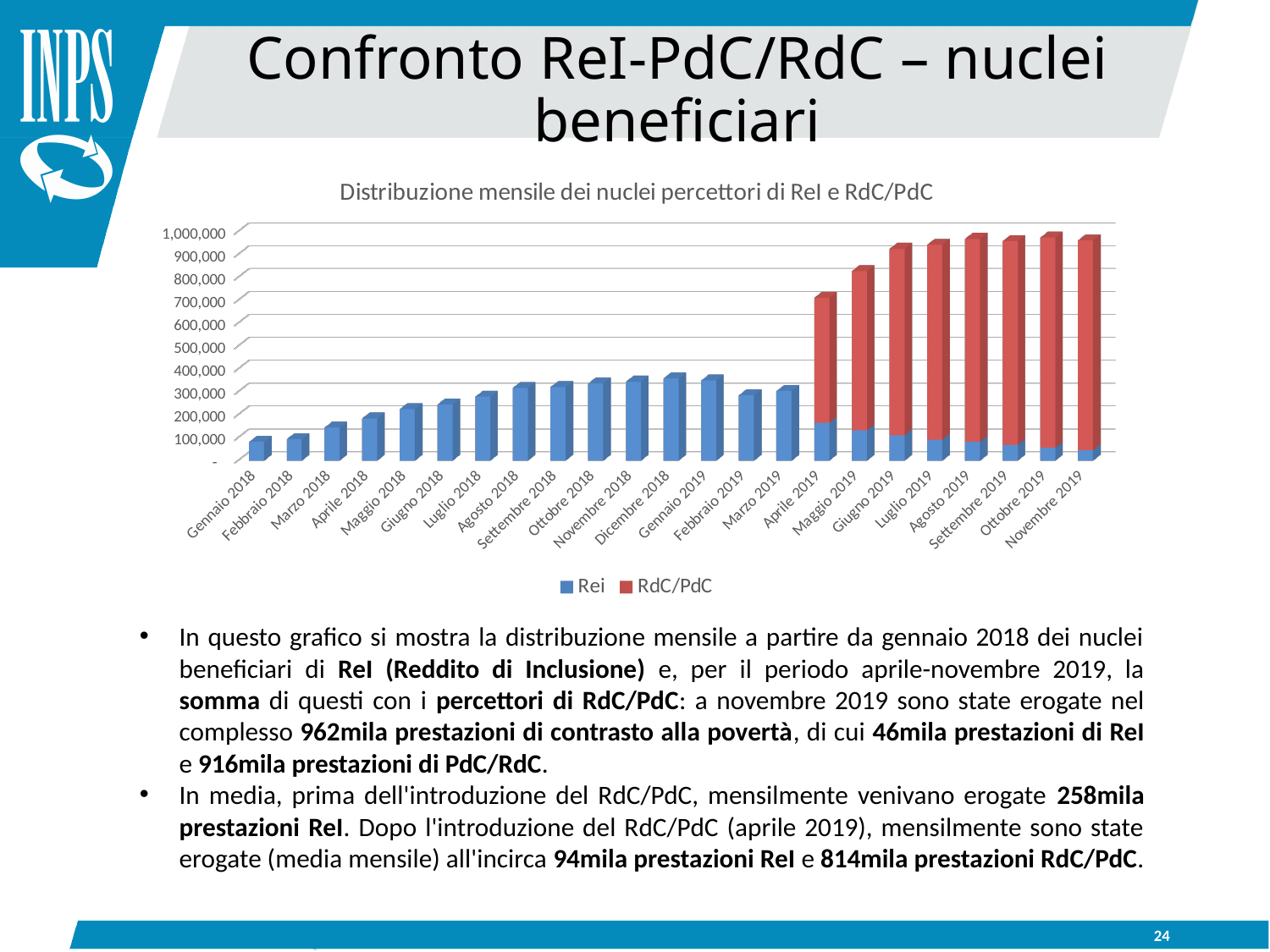
What is the title of the chart? Distribuzione mensile dei nuclei percettori di ReI e RdC/PdC Is the total bar for Luglio 2019 greater or less than 900,000? greater Which is larger, the Rei value for Dicembre 2018 or for Gennaio 2018? Dicembre 2018 Do the Rei values rise or fall from Aprile 2019 to Novembre 2019? Fall Is the Rei value for Dicembre 2018 greater or less than 300,000? greater How many months (categories) are shown on the x axis of the chart? 23 Is the total bar for Maggio 2019 greater or less than 800,000? greater Which is larger, the Rei value for Aprile 2019 or for Novembre 2019? Aprile 2019 How many series does the chart legend list? 2 Which colour represents the RdC/PdC series in the chart? Red What kind of chart is shown on the slide? Stacked bar chart